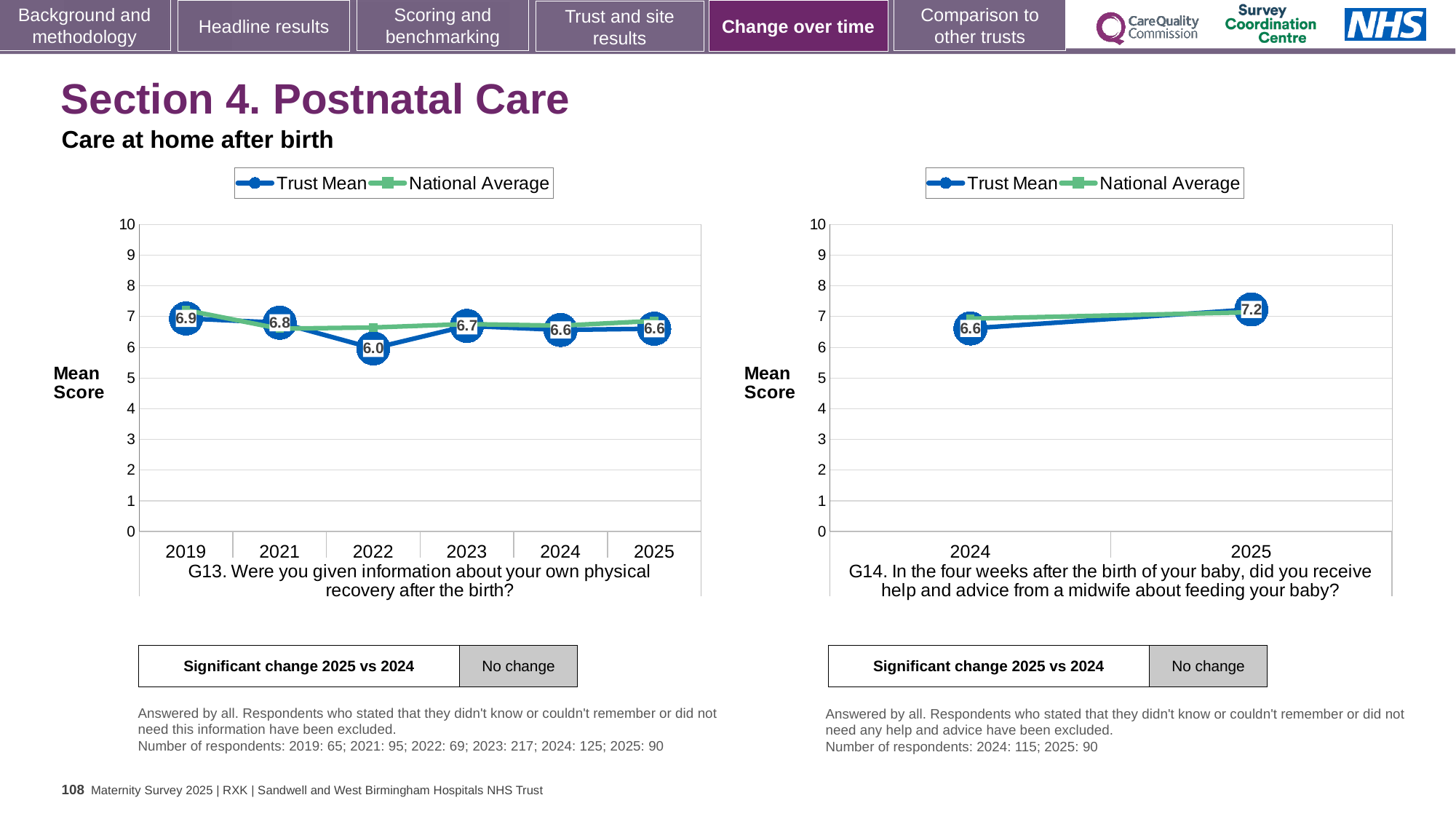
In the G13 chart on the left, is the Trust Mean score for 2021 or 2022 larger? 2021 In the G13 chart on the left, which year has the highest Trust Mean score? 2019 In the G14 chart on the right, what is the Trust Mean score for 2025? 7.2 How many series does the legend of the G14 chart on the right list? 2 What kind of chart is the G14 chart on the right? Line chart In the G14 chart on the right, is the Trust Mean value for 2024 greater or less than 7? less In the G13 chart on the left, what is the Trust Mean score for 2022? 6.0 How many years are plotted on the x axis of the G13 chart on the left? 6 In the G14 chart on the right, what is the difference between the Trust Mean scores for 2025 and 2024? 0.6 In the G13 chart on the left, what is the difference between the Trust Mean scores for 2019 and 2022? 0.9 In the G13 chart on the left, which year has the lowest Trust Mean score? 2022 In the G13 chart on the left, what is the Trust Mean score for 2019? 6.9